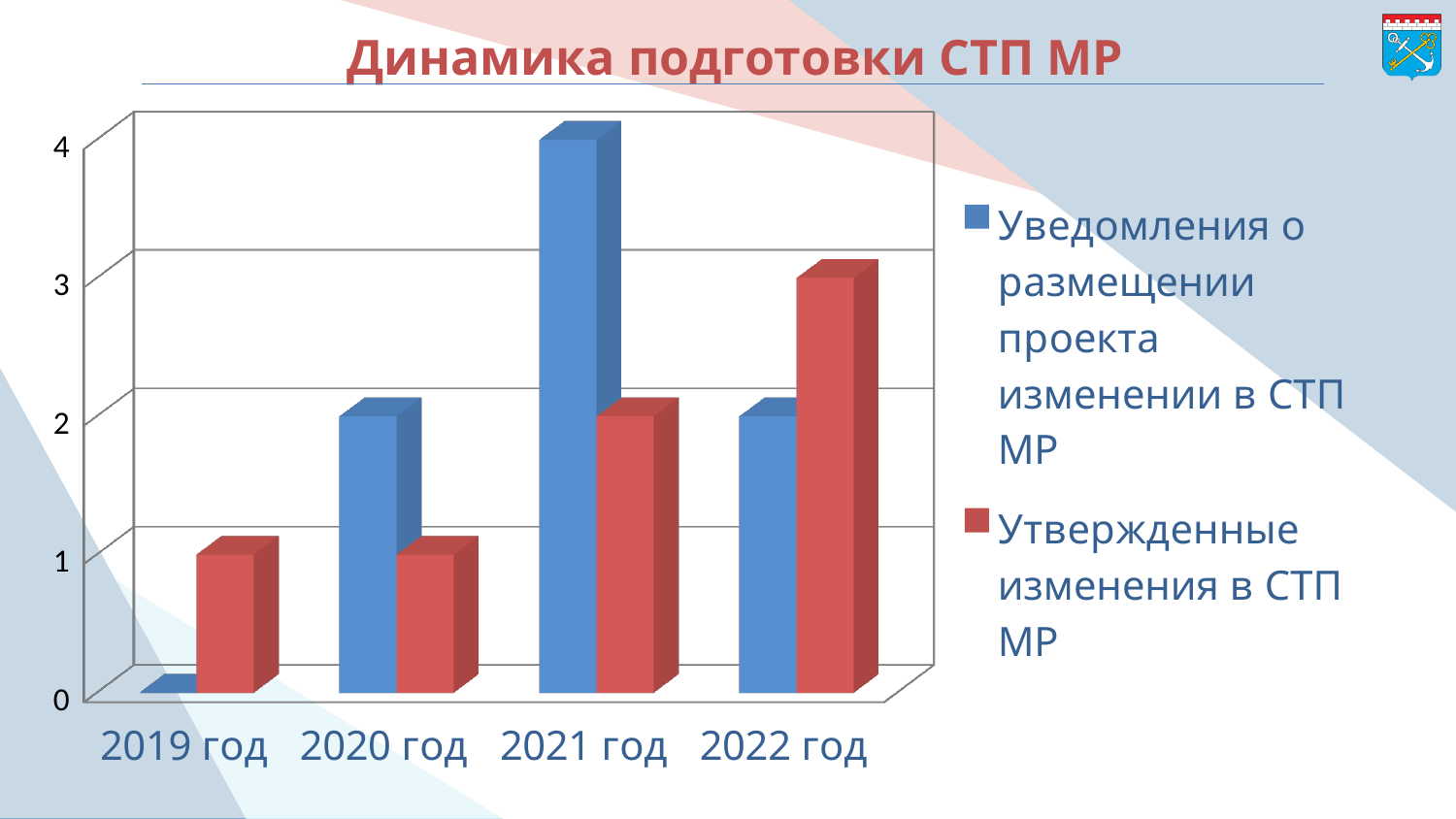
In which year is 'Уведомления о размещении проекта изменении в СТП МР' highest? 2021 год Which is larger in 2022 год: 'Уведомления о размещении проекта изменении в СТП МР' or 'Утвержденные изменения в СТП МР'? Утвержденные изменения в СТП МР What is the title of the chart? Динамика подготовки СТП МР How many year categories are shown on the x axis? 4 How many series does the legend list? 2 What is the value of 'Утвержденные изменения в СТП МР' for 2022 год? 3 What is the difference between 'Уведомления о размещении проекта изменении в СТП МР' and 'Утвержденные изменения в СТП МР' in 2021 год? 2 What is the value of 'Уведомления о размещении проекта изменении в СТП МР' for 2021 год? 4 Does 'Утвержденные изменения в СТП МР' rise or fall from 2021 год to 2022 год? rise What type of chart is shown on the slide? bar chart What is the value of 'Утвержденные изменения в СТП МР' for 2019 год? 1 In which year is 'Утвержденные изменения в СТП МР' highest? 2022 год